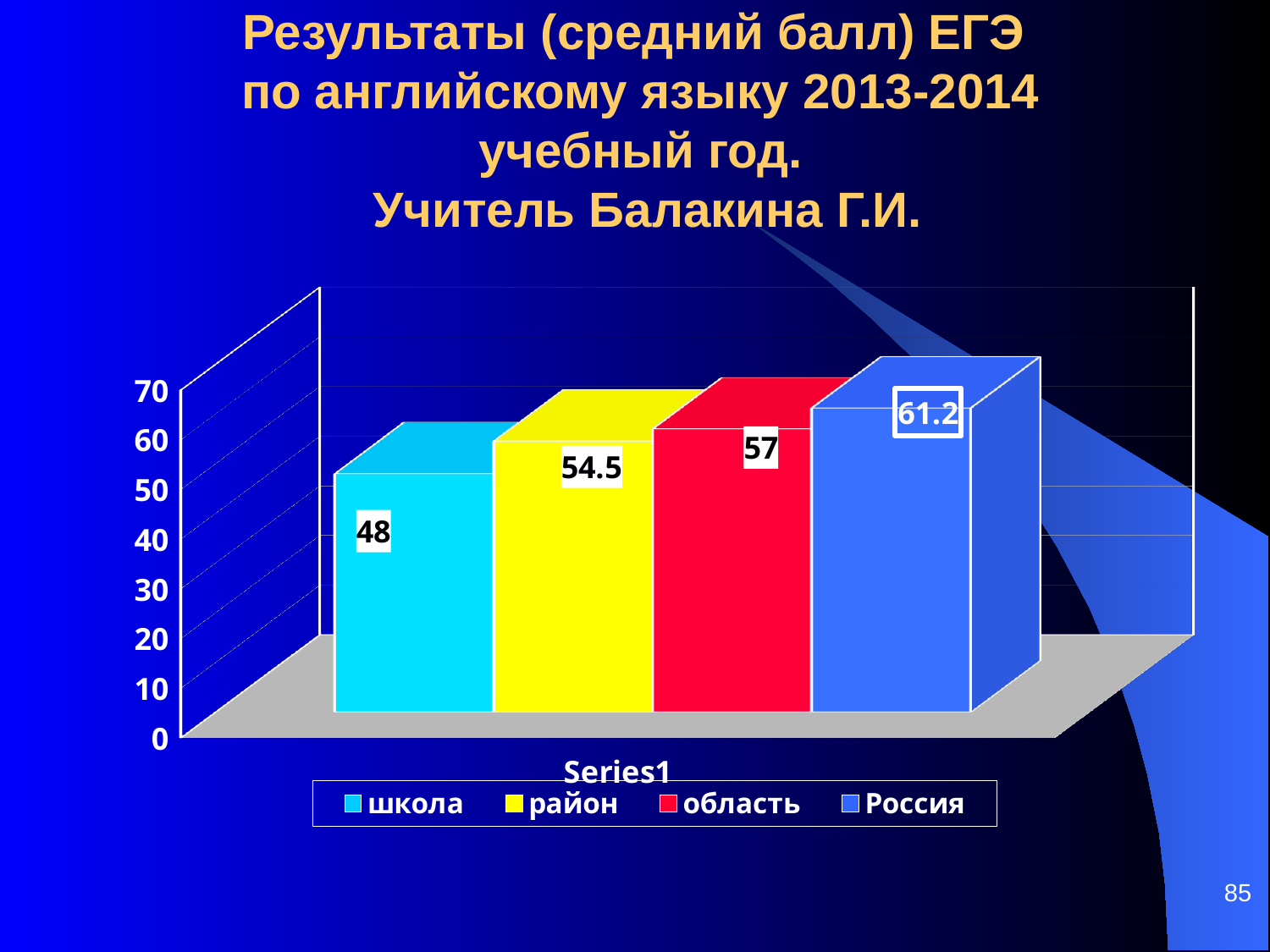
What is the value for район? 54.5 What is the difference between the values for область and район? 2.5 What colour is the bar for область? red Which category has the lowest value? школа Which category has the highest value? Россия What is the difference between the values for Россия and школа? 13.2 What is the value for область? 57 What is the value for Россия? 61.2 Which is larger, the value for район or the value for область? область What kind of chart is shown on the slide? bar chart What is the value for школа? 48 How many bars are shown in the chart? 4